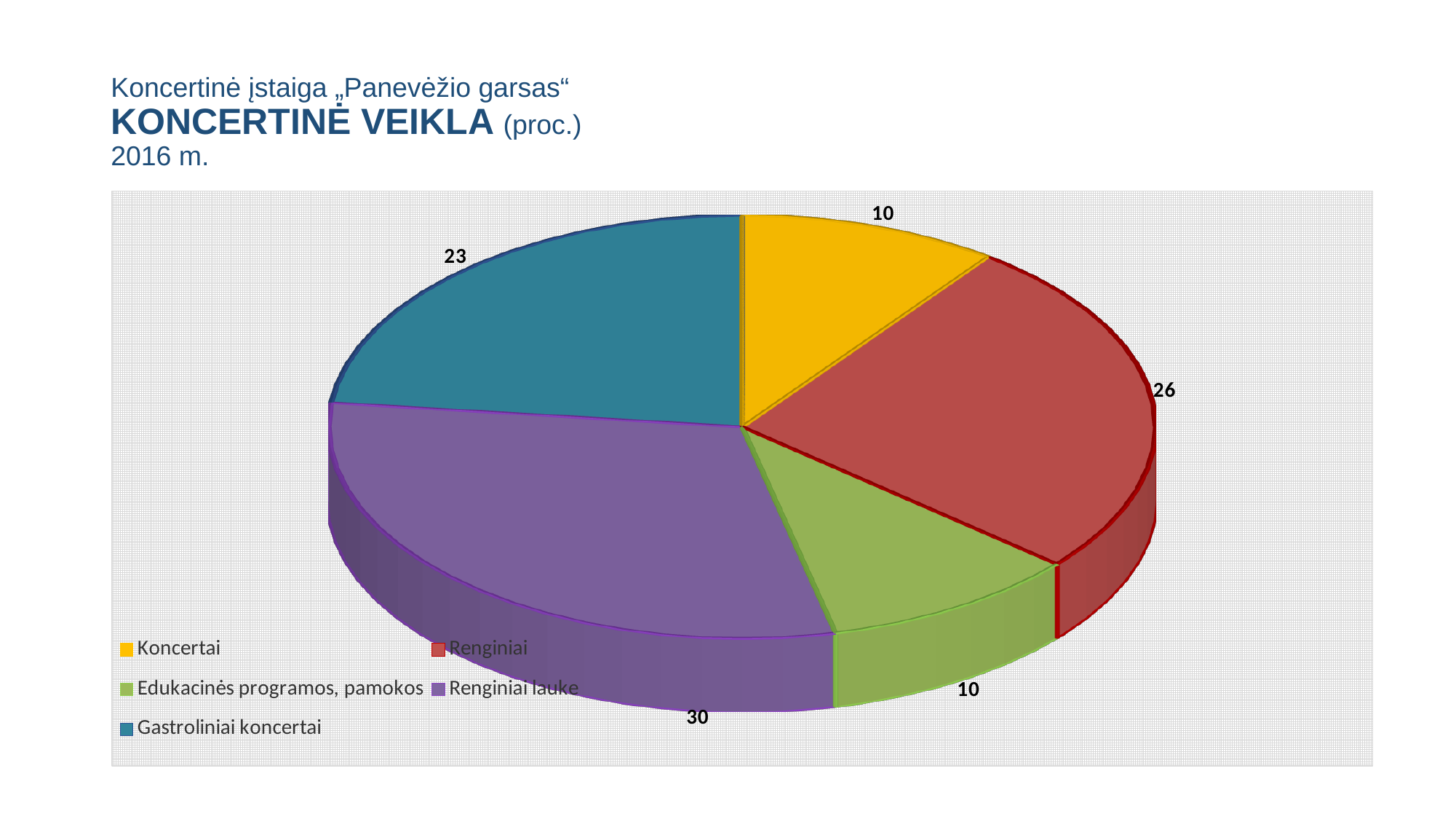
What is the difference between the values for Renginiai lauke and Gastroliniai koncertai? 7 Which is larger, the value for Renginiai or the value for Gastroliniai koncertai? Renginiai What is the value for Gastroliniai koncertai? 23 What is the value for Renginiai lauke? 30 How many categories does the pie chart have? 5 Which colour represents Gastroliniai koncertai in the legend? teal What is the value for Koncertai? 10 Which category has the largest slice of the pie? Renginiai lauke What type of chart is shown on the slide? pie chart What is the difference between the values for Renginiai and Koncertai? 16 What is the value for Renginiai? 26 What is the value for Edukacinės programos, pamokos? 10